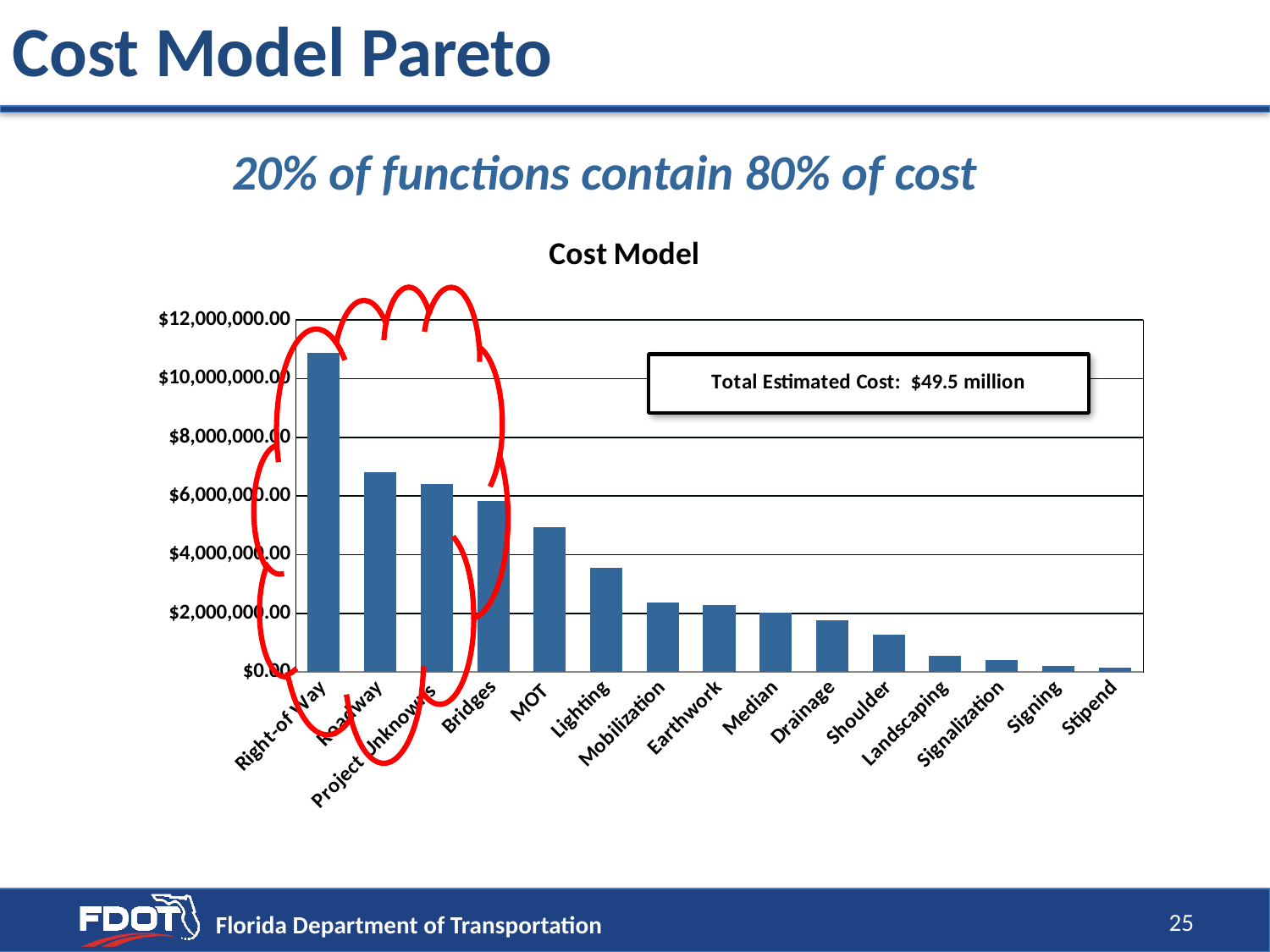
Do the bar values rise or fall from left to right along the x axis? fall Is the value for MOT greater or less than $4,000,000.00? greater Is the value for Lighting greater or less than $4,000,000.00? less Is the value for Shoulder greater or less than $2,000,000.00? less What total estimated cost is stated in the text box on the chart? $49.5 million Which has the larger value, Roadway or Bridges? Roadway Which category has the highest cost in the Cost Model chart? Right-of-Way How many categories are plotted on the x axis of the Cost Model chart? 15 What kind of chart is shown on the slide? bar chart